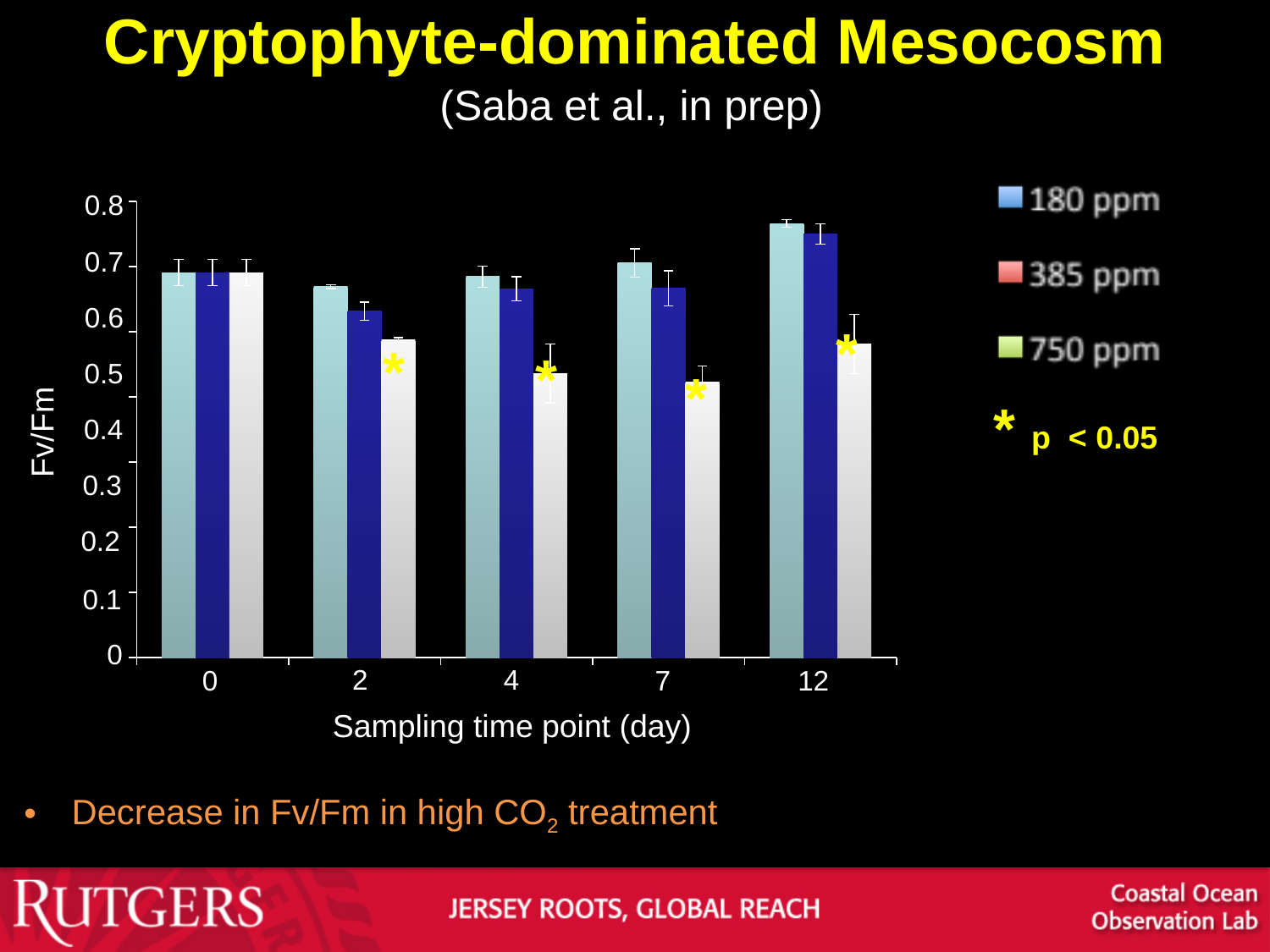
Does the value for 750 ppm rise or fall from day 0 to day 7? fall Is the value for 180 ppm at day 12 greater or less than 0.7? greater What is the label of the y axis? Fv/Fm What is the label of the x axis? Sampling time point (day) At day 2, which is larger: the value for 180 ppm or the value for 750 ppm? 180 ppm At day 7, which series has the lowest Fv/Fm? 750 ppm Is the value for 180 ppm at day 0 greater or less than 0.6? greater How many sampling time points are shown on the x axis? 5 Is the value for 750 ppm at day 4 greater or less than 0.6? less What kind of chart is shown on the slide? bar chart How many series does the legend list? 3